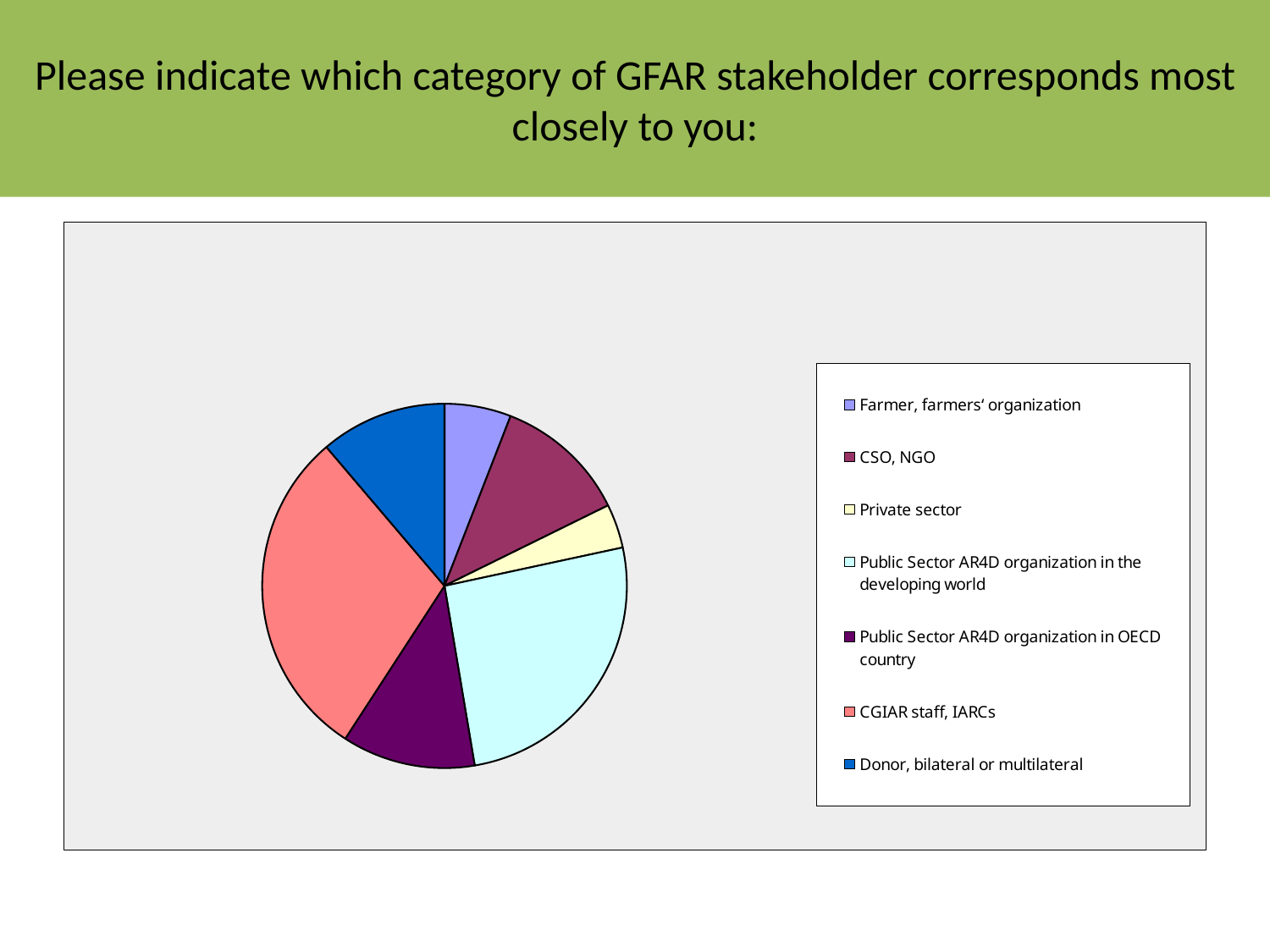
How many stakeholder categories does the pie chart show? 7 Which slice is larger: "Farmer, farmers' organization" or "CSO, NGO"? CSO, NGO What kind of chart is shown on the slide? Pie chart What colour is the slice for "Donor, bilateral or multilateral"? Blue Which slice is larger: "Public Sector AR4D organization in OECD country" or "Private sector"? Public Sector AR4D organization in OECD country Which slice is larger: "Public Sector AR4D organization in the developing world" or "Public Sector AR4D organization in OECD country"? Public Sector AR4D organization in the developing world Which stakeholder category has the smallest slice of the pie? Private sector What is the title of the slide containing the pie chart? Please indicate which category of GFAR stakeholder corresponds most closely to you: